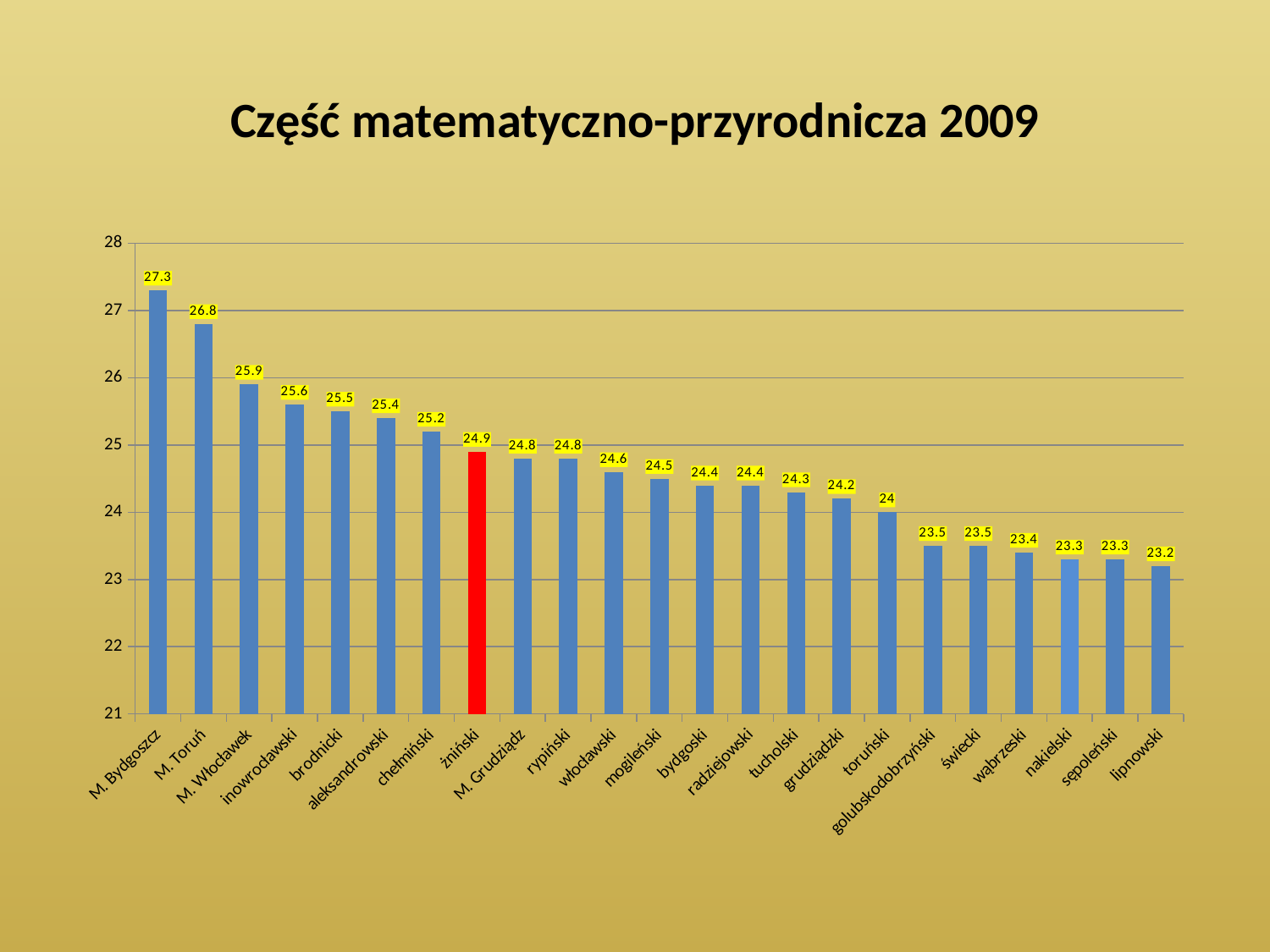
What is the difference between the values for żniński and M. Grudziądz? 0.1 What is the value for M. Toruń? 26.8 Is the value for M. Włocławek greater or less than 25? greater Which category has the lowest value? lipnowski What is the difference between the values for M. Bydgoszcz and lipnowski? 4.1 How many categories are shown on the x axis? 23 What kind of chart is shown on the slide? bar chart What is the value for toruński? 24 Which category has the highest value? M. Bydgoszcz What is the value for żniński? 24.9 Which bar is coloured red instead of blue? żniński Which is larger, the value for chełmiński or the value for tucholski? chełmiński